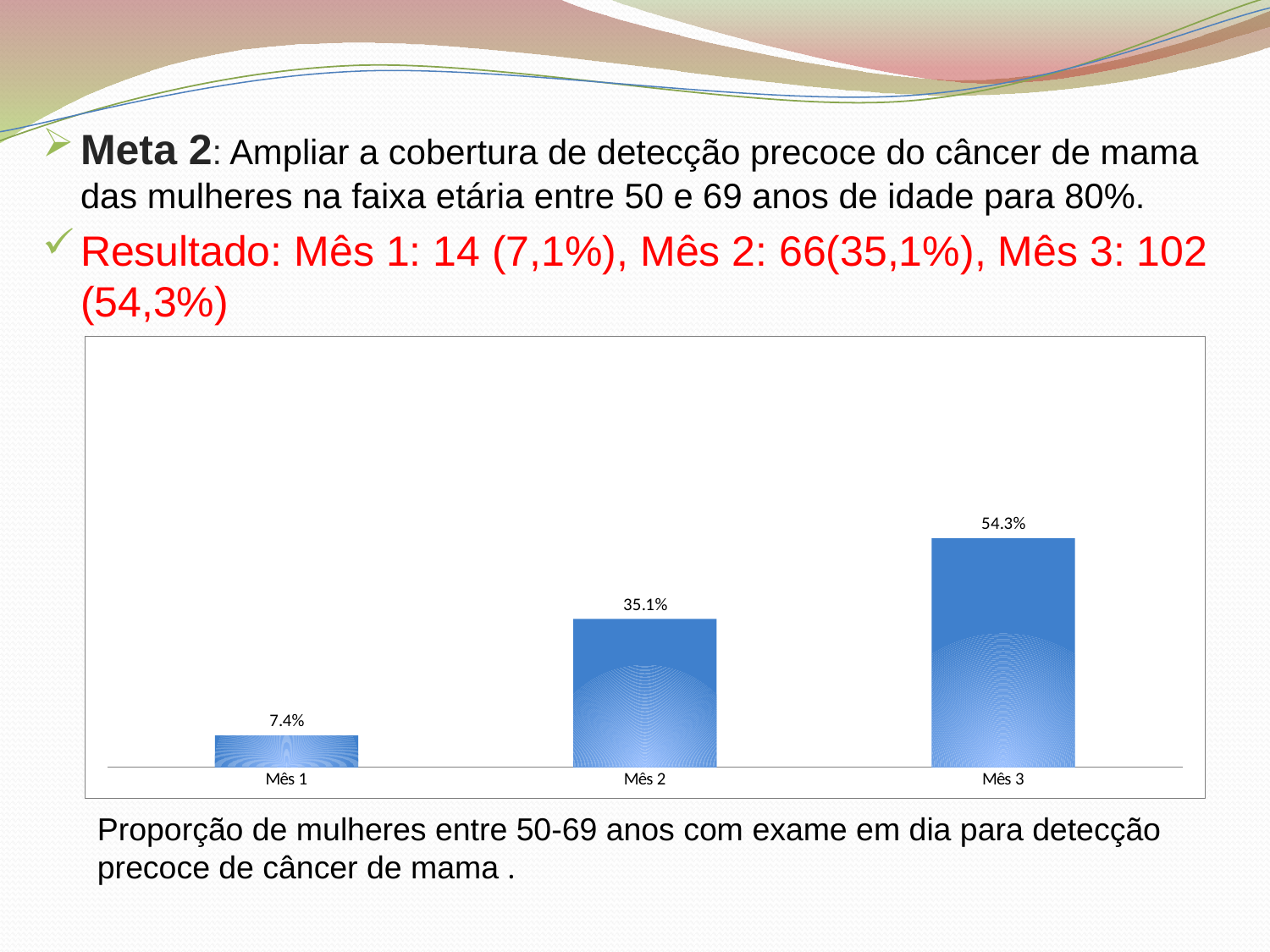
What is the value for Mês 2? 35.1% What kind of chart is shown on the slide? Bar chart What is the value for Mês 1? 7.4% Which month has the highest value? Mês 3 Which month has the lowest value? Mês 1 What is the difference between the values for Mês 2 and Mês 1? 27.7% What colour are the bars in the chart? Blue What is the difference between the values for Mês 3 and Mês 2? 19.2% How many categories are shown on the x axis? 3 Which is larger, the value for Mês 1 or the value for Mês 2? Mês 2 Do the values rise or fall from Mês 1 to Mês 3? Rise What is the value for Mês 3? 54.3%